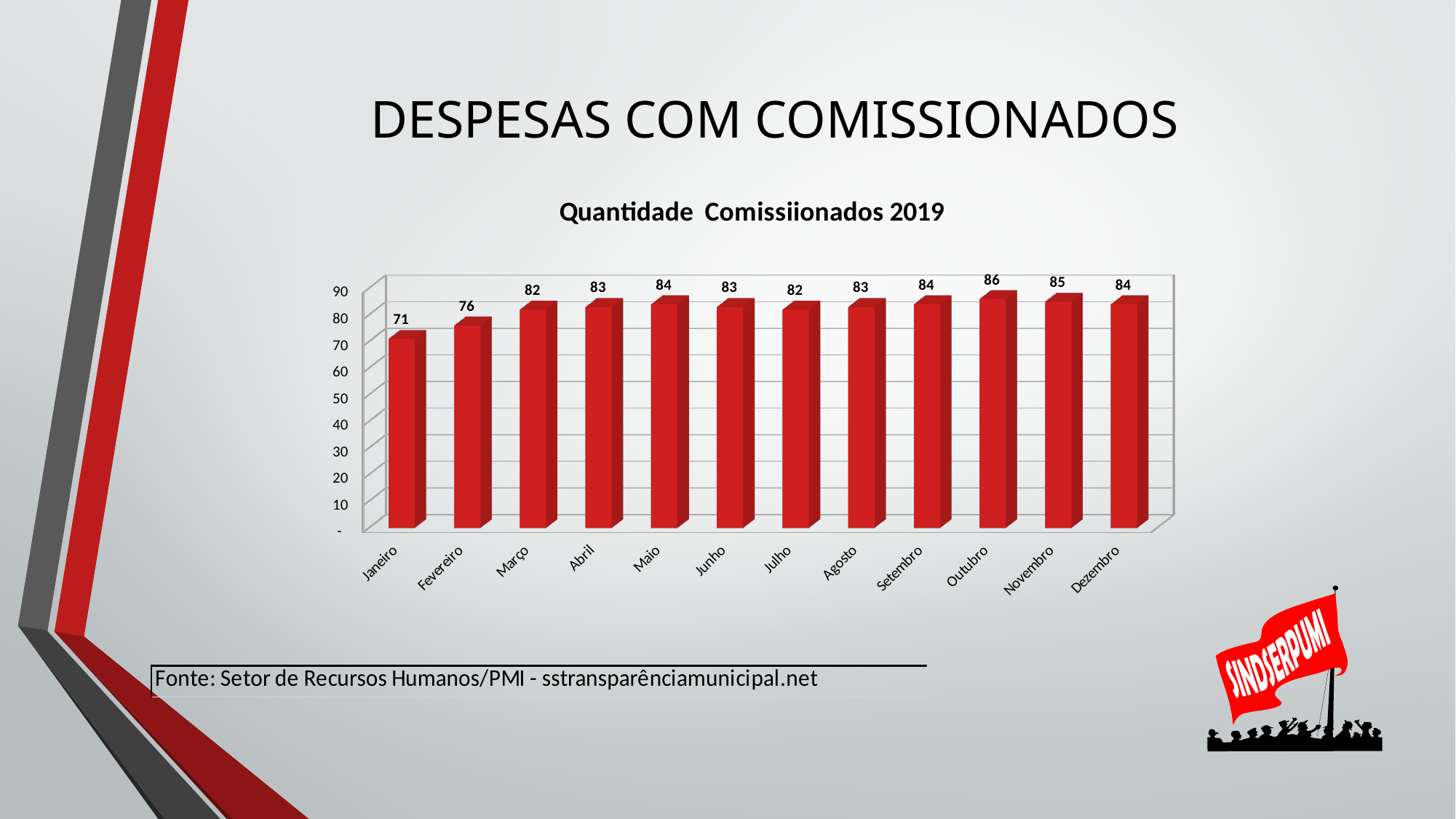
Which month has the lowest value? Janeiro What is the difference between the values for Outubro and Janeiro? 15 Which month has the highest value? Outubro Do the values generally rise or fall from Janeiro to Março? rise How many months are shown on the x axis? 12 Is the value for Janeiro greater or less than 80? less Which is larger, the value for Fevereiro or the value for Março? Março What is the value for Outubro? 86 What is the title of the chart? Quantidade Comissiionados 2019 What kind of chart is shown? bar chart What is the value for Janeiro? 71 What is the value for Fevereiro? 76